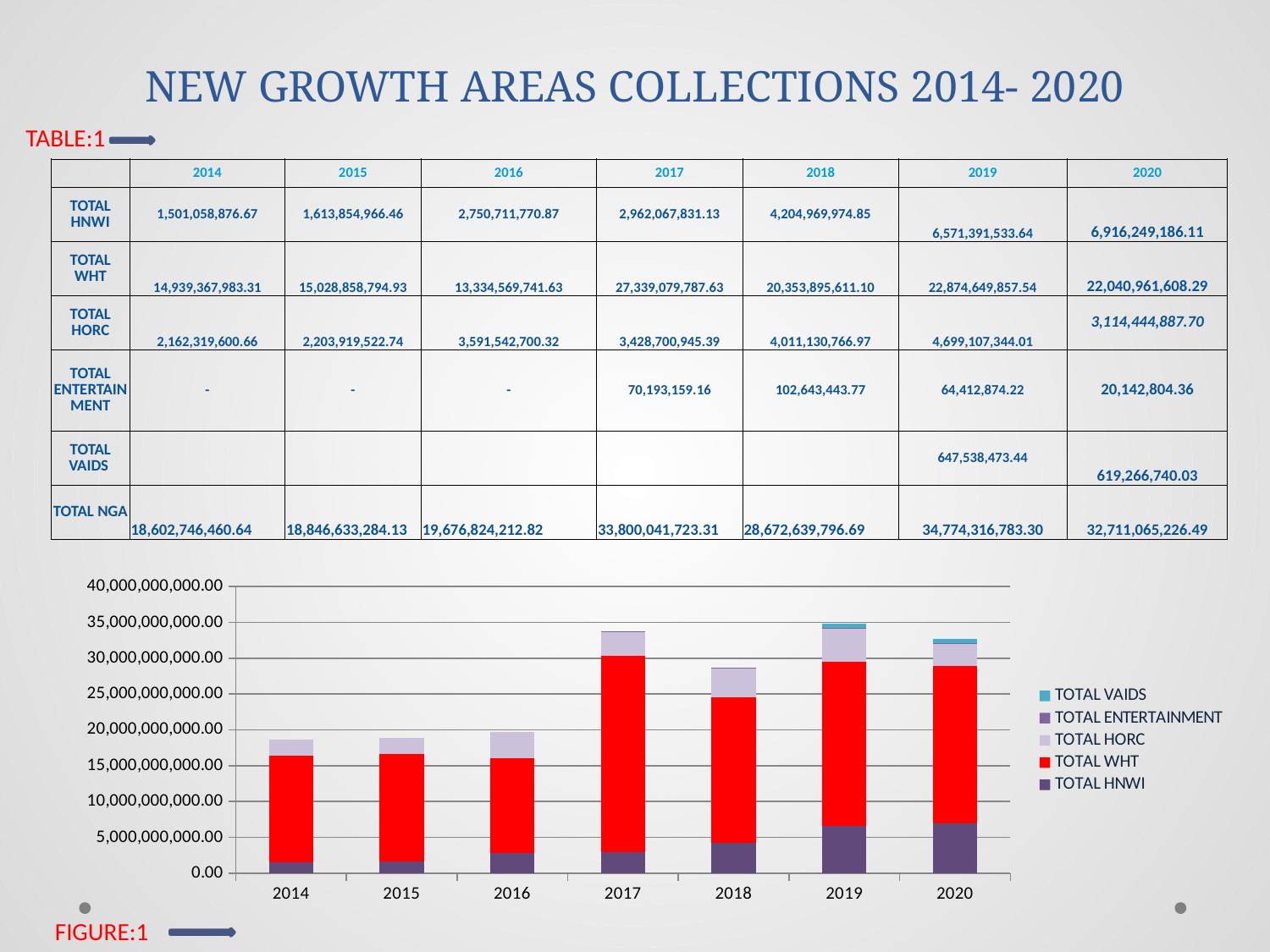
How many years are shown on the x axis of Figure 1? 7 In Figure 1, is the total stacked bar for 2015 greater or less than 20,000,000,000.00? less In Figure 1, what colour represents TOTAL WHT? red In Figure 1, does the TOTAL HNWI segment rise or fall from 2014 to 2020? rises What type of chart is Figure 1? bar chart How many series does the legend of Figure 1 list? 5 In Figure 1, is the total stacked bar for 2017 greater or less than 30,000,000,000.00? greater In Figure 1, which year has the taller stacked bar, 2017 or 2018? 2017 Using the TOTAL NGA values in Table 1, what is the difference between 2019 and 2020? 2,063,251,556.81 According to Table 1, what is the TOTAL NGA value for 2019? 34,774,316,783.30 In Figure 1, which year has the tallest stacked bar? 2019 According to Table 1, what is the TOTAL WHT value for 2017? 27,339,079,787.63